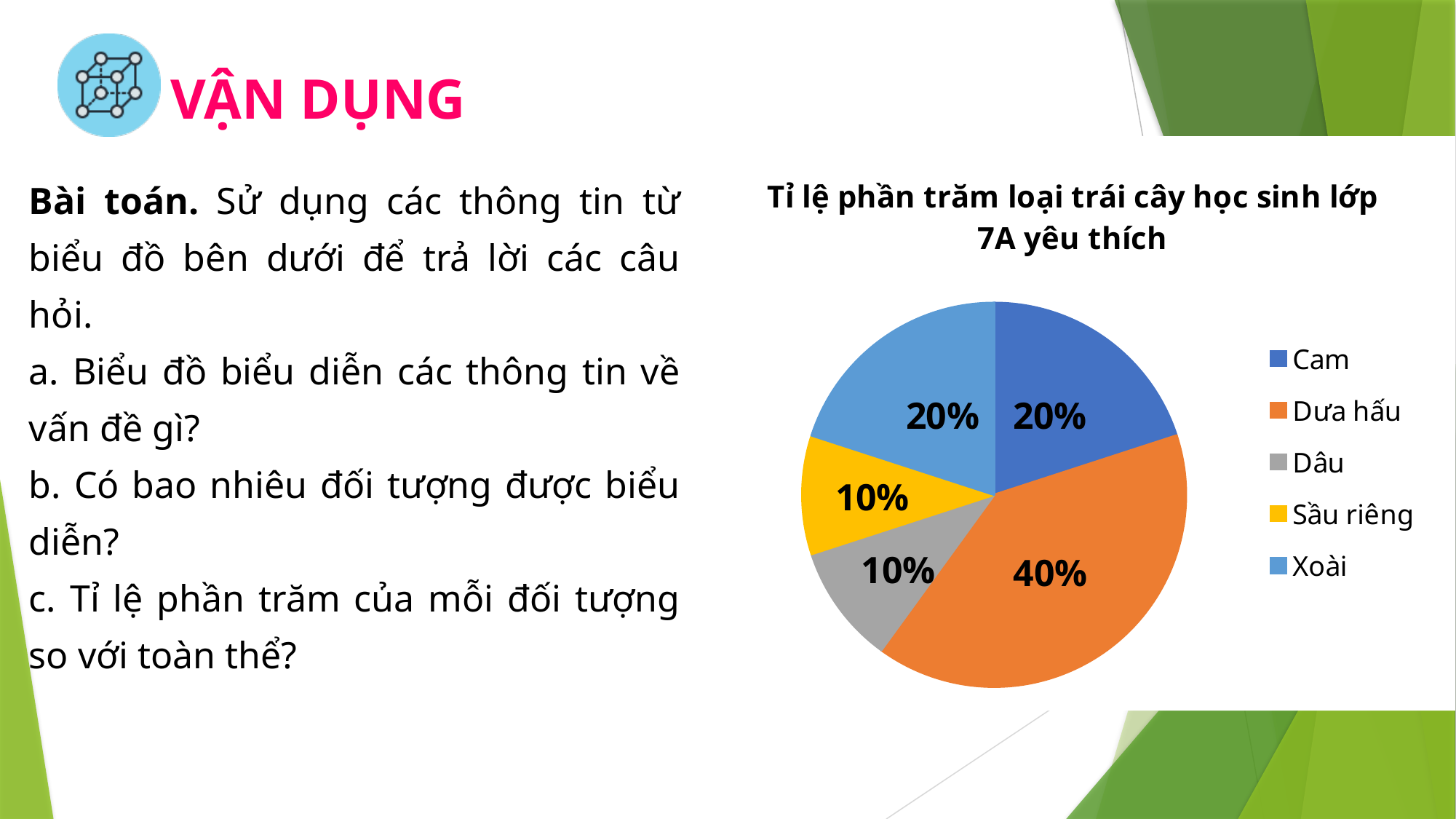
Which is larger, the slice for Dưa hấu or the slice for Cam? Dưa hấu What is the difference in percentage points between Dưa hấu and Dâu? 30% What is the title of the chart? Tỉ lệ phần trăm loại trái cây học sinh lớp 7A yêu thích What kind of chart is shown on the slide? Pie chart How many fruit categories are shown in the pie chart? 5 What is the difference in percentage points between Xoài and Sầu riêng? 10% What percentage does the chart show for Xoài? 20% What share of the pie does Dâu represent? 10% What percentage does the chart show for Dưa hấu? 40% What percentage does the chart show for Cam? 20% Which fruit has the largest slice of the pie? Dưa hấu What percentage does the chart show for Sầu riêng? 10%